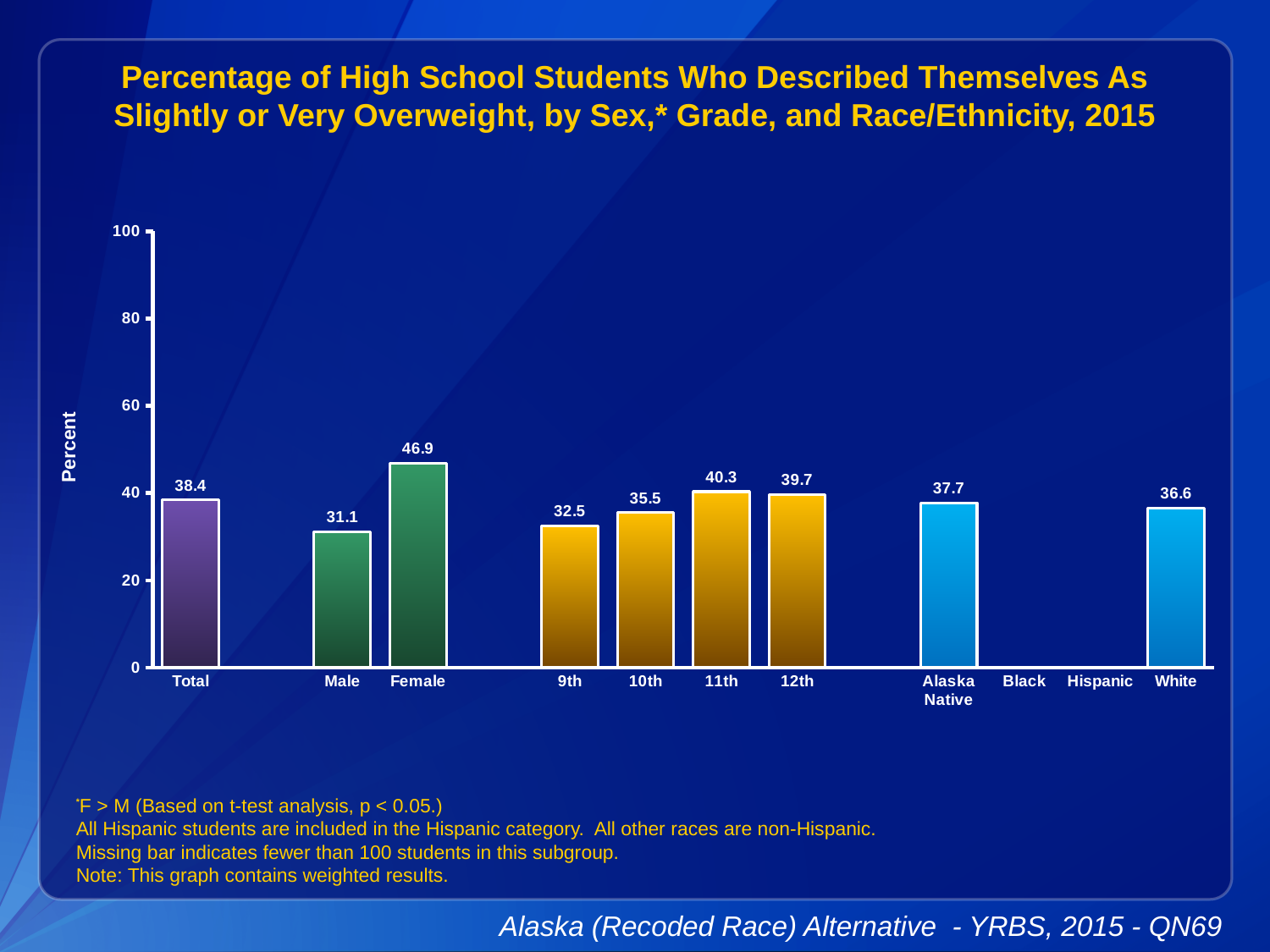
What is the label on the y axis? Percent How many bars are plotted on the chart? 9 Is the value for White greater or less than 40? less What is the value for Alaska Native? 37.7 What is the difference between the Female and Male values? 15.8 What is the value for Female? 46.9 Which category has the highest value? Female What kind of chart is shown? bar chart What is the value for Total? 38.4 Which category has the lowest value among the bars shown? Male Which is larger, the value for 9th grade or the value for 12th grade? 12th What is the value for 11th grade? 40.3